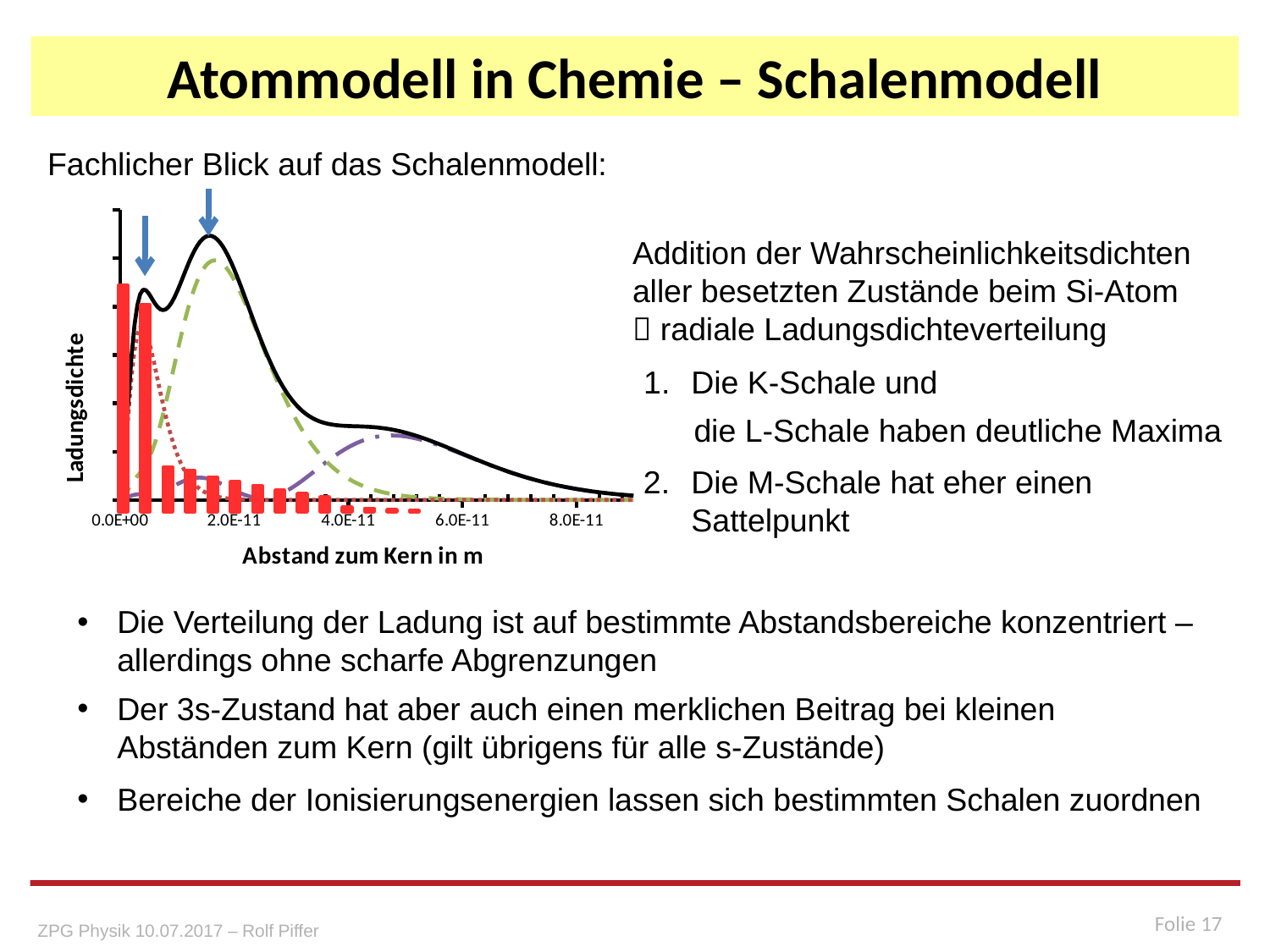
Is the x position of the highest peak of the solid black curve greater or less than 2.0E-11? less What is the largest value labelled on the x axis of the chart? 8.0E-11 Is the x position of the peak of the purple dash-dot curve greater or less than 4.0E-11? greater What kind of chart is shown on the slide? line chart Does the chart show a legend? no Which curve reaches the highest point on the chart, the solid black curve or the purple dash-dot curve? the solid black curve Does the solid black curve rise or fall along the x axis between 2.0E-11 and 8.0E-11? fall What is the smallest value labelled on the x axis of the chart? 0.0E+00 What is the title of the y axis of the chart? Ladungsdichte What is the title of the x axis of the chart? Abstand zum Kern in m How many labelled tick marks are shown on the x axis of the chart? 5